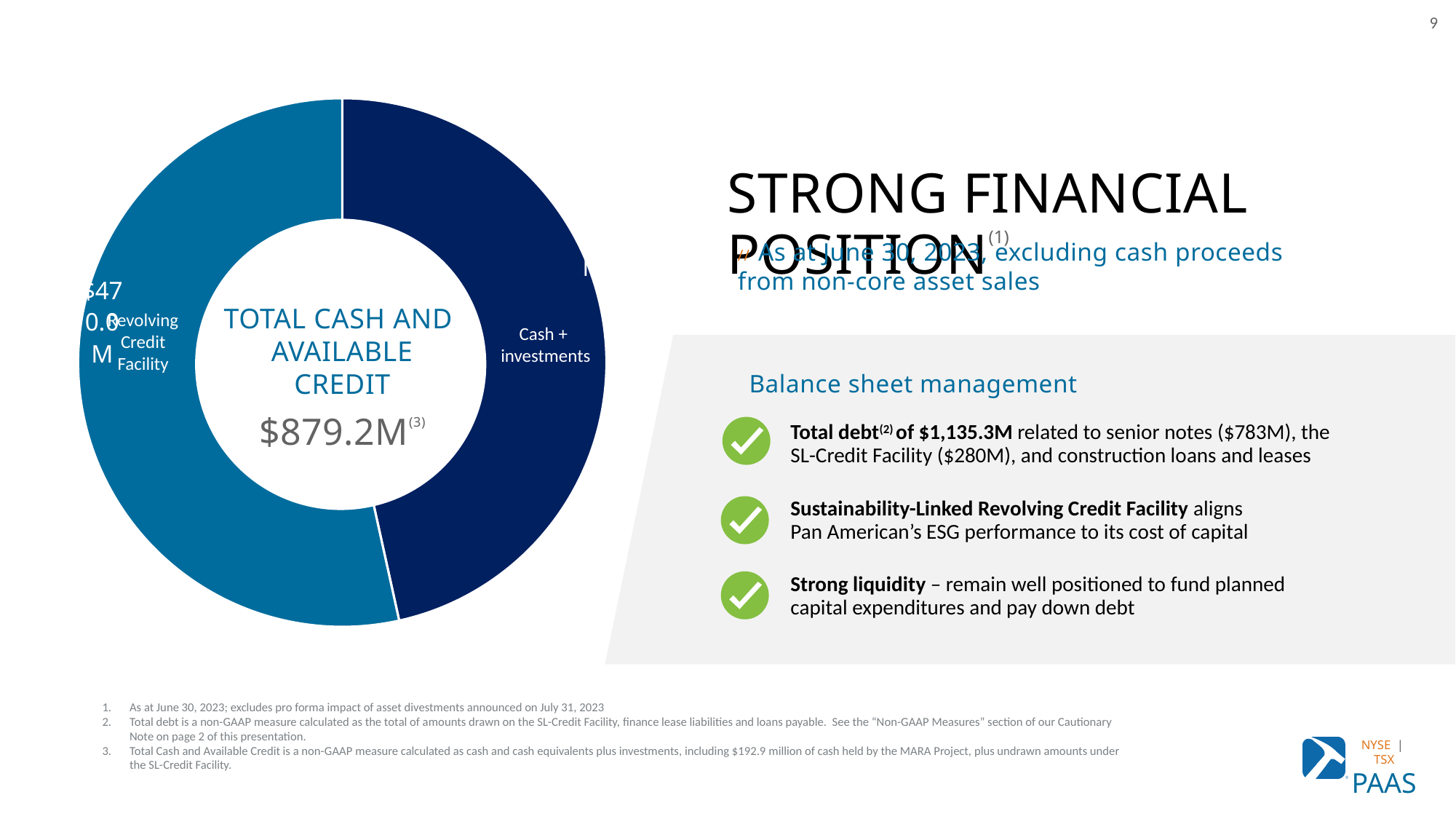
How many slices does the donut chart have? 2 What does the text in the centre of the donut chart say the total represents? Total cash and available credit Which slice of the donut chart is coloured dark navy blue? Cash + investments What kind of chart is shown on the slide? Pie (donut) chart What are the two categories shown in the donut chart? Revolving Credit Facility and Cash + investments What total value is printed in the centre of the donut chart? $879.2M